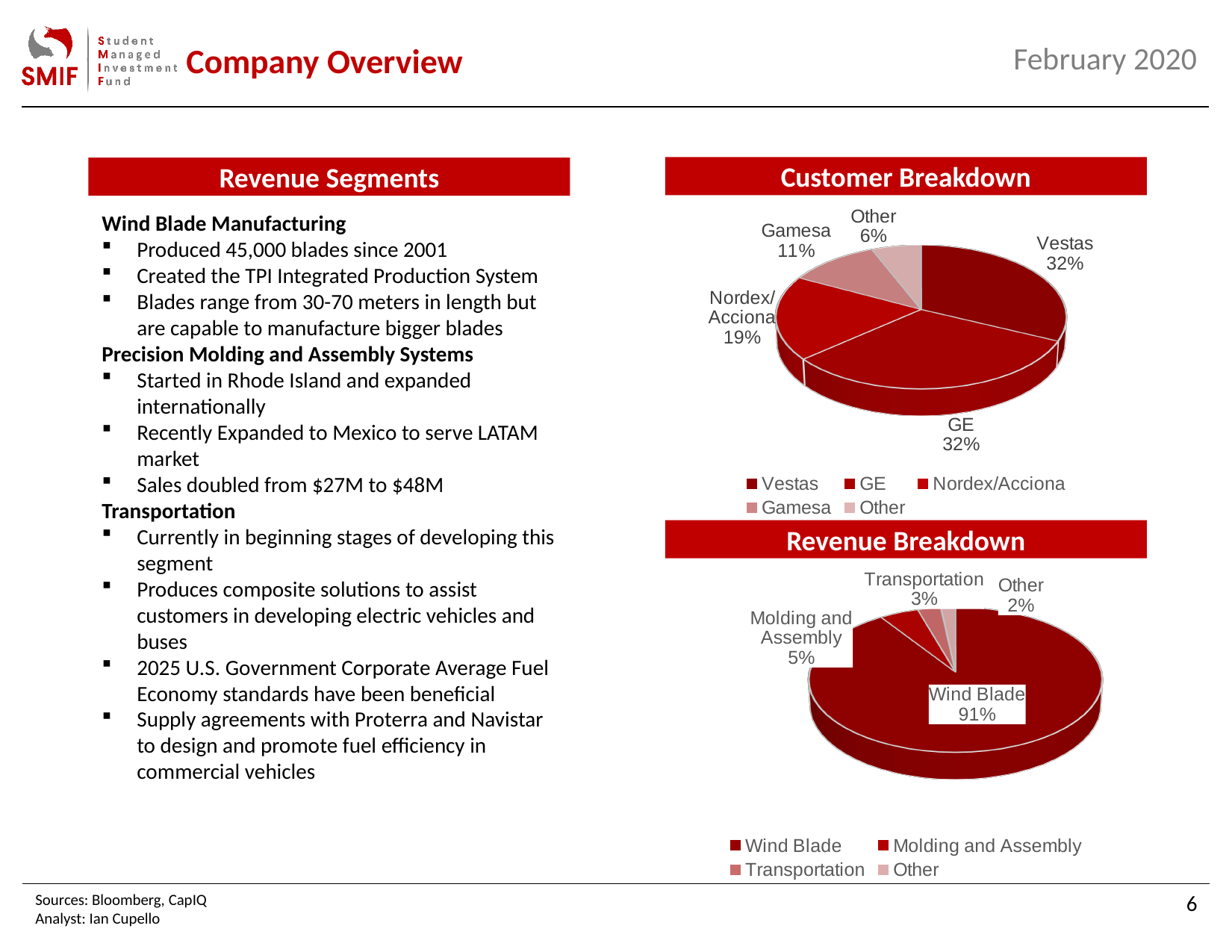
In the Revenue Breakdown chart, what percentage is shown for Molding and Assembly? 5% In the Revenue Breakdown chart, which segment has the largest share of revenue? Wind Blade What type of chart is the Revenue Breakdown chart? Pie chart In the Revenue Breakdown chart, what is the difference between the Transportation share and the Other share? 1% How many entries does the legend of the Revenue Breakdown chart list? 4 In the Customer Breakdown chart, which is larger, the share for Nordex/Acciona or the share for Gamesa? Nordex/Acciona In the Customer Breakdown chart, which customer has the smallest share? Other In the Customer Breakdown chart, what is the difference between the Vestas share and the Gamesa share? 21% In the Revenue Breakdown chart, what share of revenue comes from Wind Blade? 91% In the Customer Breakdown chart, what share of customers does Nordex/Acciona represent? 19% In the Customer Breakdown chart, what percentage is shown for Gamesa? 11% In the Customer Breakdown chart, how many customer categories are shown? 5